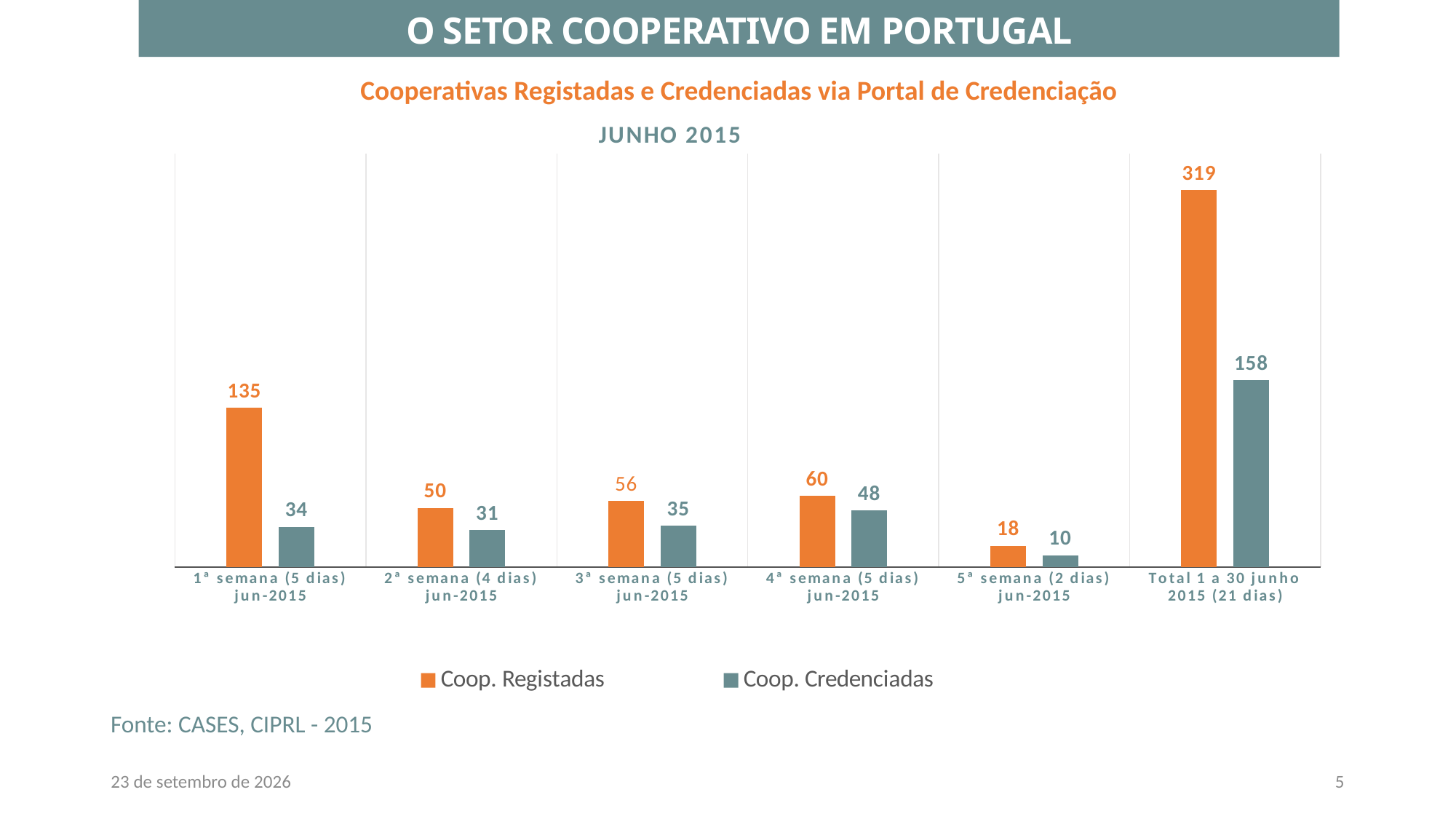
How many series does the legend list? 2 Which category has the highest value for Coop. Credenciadas? Total 1 a 30 junho 2015 (21 dias) What is the value of Coop. Credenciadas for Total 1 a 30 junho 2015 (21 dias)? 158 How many categories are shown on the x axis? 6 Which is larger: Coop. Registadas for 3ª semana (5 dias) jun-2015 or Coop. Registadas for 4ª semana (5 dias) jun-2015? 4ª semana (5 dias) jun-2015 What kind of chart is shown on the slide? Bar chart What is the difference between Coop. Registadas and Coop. Credenciadas for 1ª semana (5 dias) jun-2015? 101 What is the value of Coop. Registadas for 1ª semana (5 dias) jun-2015? 135 What is the value of Coop. Credenciadas for 4ª semana (5 dias) jun-2015? 48 What is the difference between Coop. Registadas and Coop. Credenciadas for Total 1 a 30 junho 2015 (21 dias)? 161 Among the weekly categories (excluding the total), which week has the lowest value for Coop. Registadas? 5ª semana (2 dias) jun-2015 What is the chart's title? JUNHO 2015